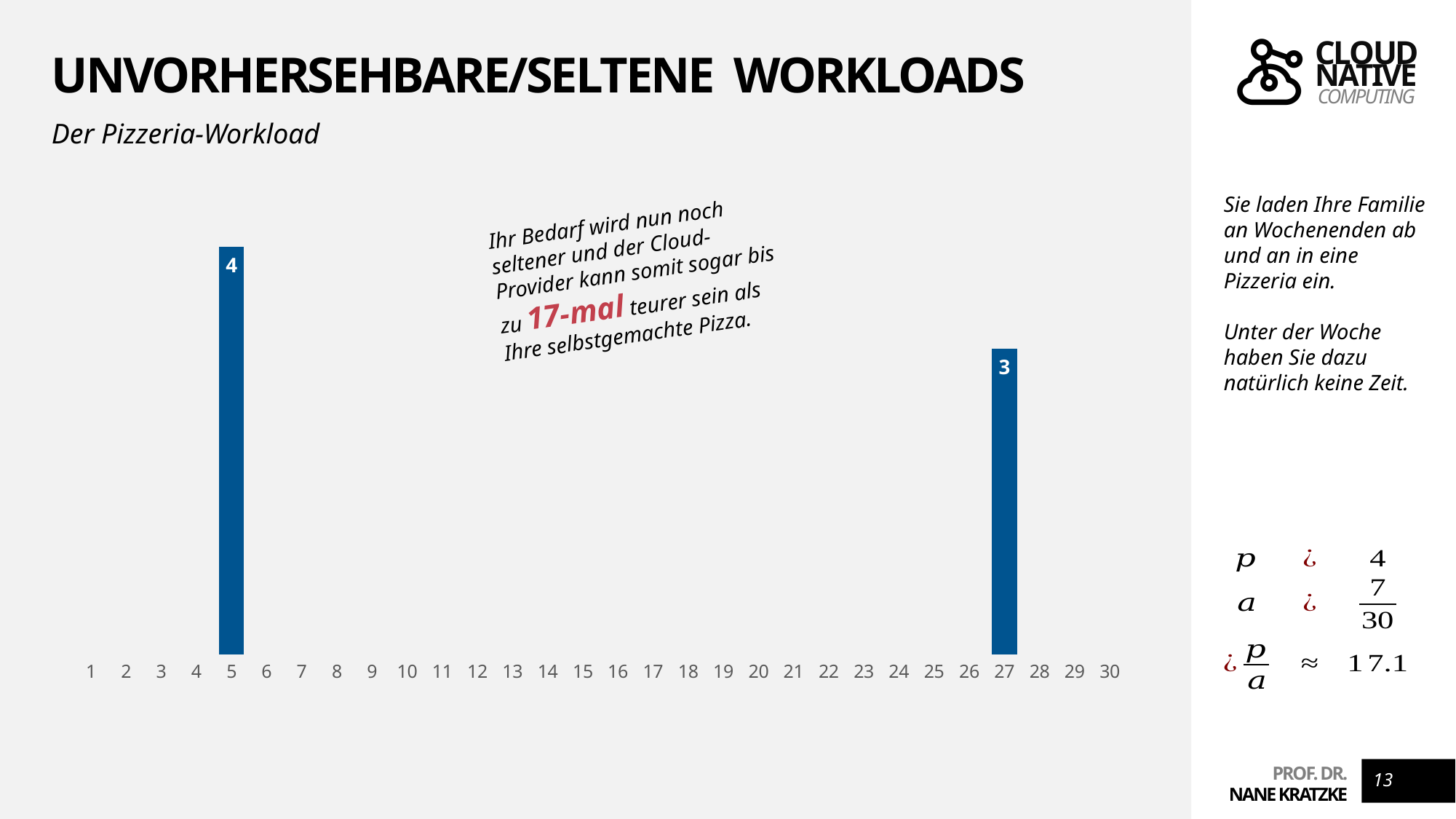
What is the value of the bar at category 5? 4 What is the subtitle shown above the chart? Der Pizzeria-Workload Which is larger, the bar at category 5 or the bar at category 27? Category 5 Of the two bars shown, which category has the lower value? 27 How many bars with a non-zero value are plotted? 2 How many categories are labelled on the x axis? 30 Which category has the highest bar? 5 What colour are the bars in the chart? Blue What is the total of the two plotted bar values? 7 What is the difference between the bar at category 5 and the bar at category 27? 1 What kind of chart is shown on the slide? Bar chart What is the value of the bar at category 27? 3